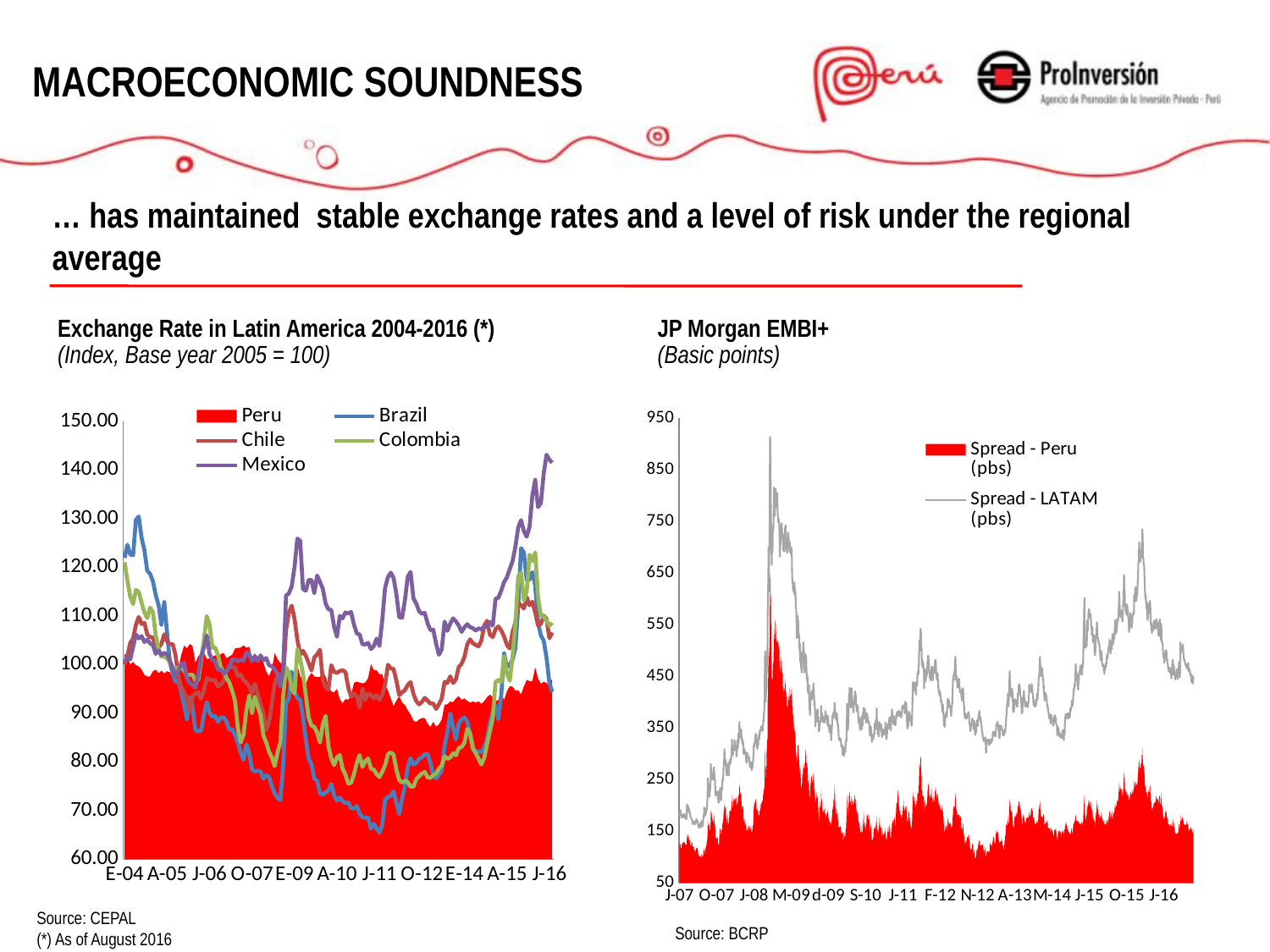
In the JP Morgan EMBI+ chart, how many series does the legend list? 2 In the Exchange Rate in Latin America chart, is the value for Peru at J-16 greater or less than 100.00? less In the Exchange Rate in Latin America chart, which series is drawn as a filled red area? Peru In the Exchange Rate in Latin America chart, which series has the highest value at J-16? Mexico In the JP Morgan EMBI+ chart, which series is higher at J-16, Spread - Peru or Spread - LATAM? Spread - LATAM In the JP Morgan EMBI+ chart, is the peak value of Spread - LATAM (around 2008-2009) greater or less than 850? greater In the JP Morgan EMBI+ chart, is the value for Spread - LATAM at J-07 greater or less than 250? less In the Exchange Rate in Latin America chart, how many series does the legend list? 5 What is the base year of the index in the Exchange Rate in Latin America chart? 2005 = 100